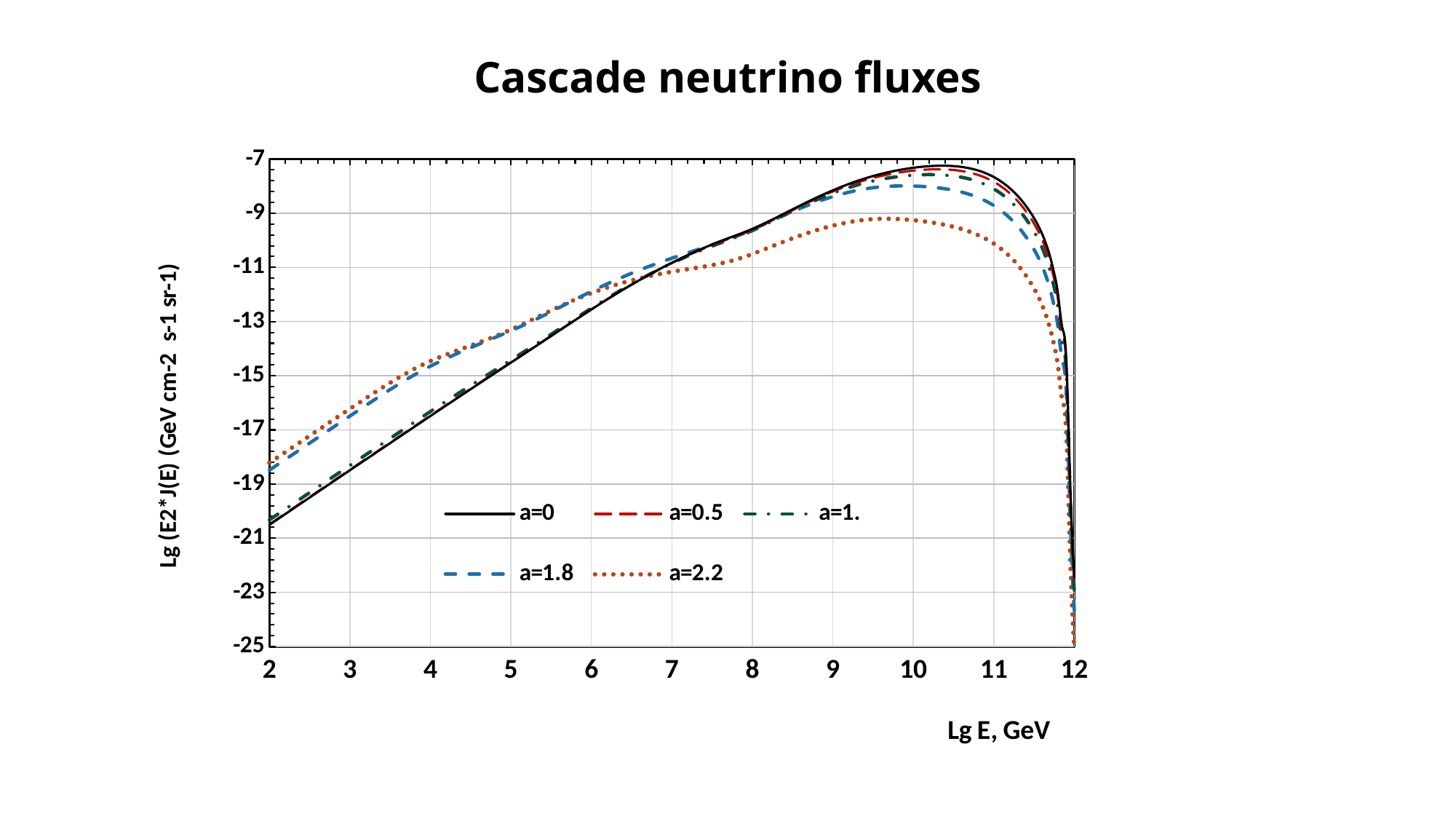
At Lg E = 4, which series has the larger value, a=2.2 or a=0? a=2.2 Which series has the lowest peak value? a=2.2 What is the title of the chart? Cascade neutrino fluxes What kind of chart is shown on the slide? line chart Is the value of the a=0 series at Lg E = 2 greater or less than -19? less How many series does the legend list? 5 Do the values of all series rise or fall as Lg E approaches 12? fall What is the label of the x axis? Lg E, GeV Is the value of the a=2.2 series at Lg E = 10 greater or less than -11? greater Is the value of the a=2.2 series at Lg E = 2 greater or less than -19? greater Do the values of the a=0 series rise or fall as Lg E increases from 2 to 10? rise At Lg E = 10, which series has the larger value, a=0 or a=2.2? a=0